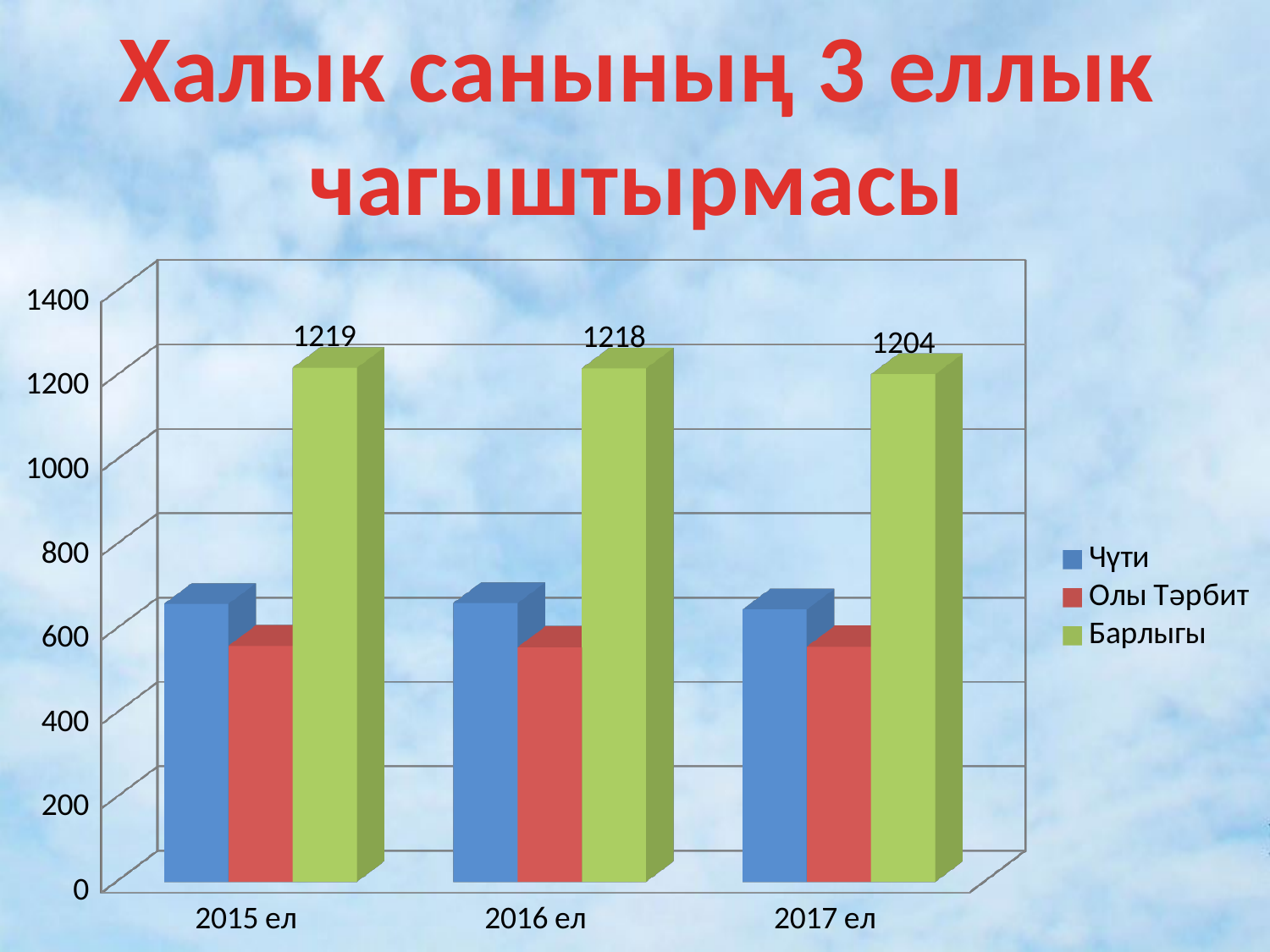
What is the value of Барлыгы for 2015 ел? 1219 What is the difference between the Барлыгы values for 2015 ел and 2017 ел? 15 Which year has the highest Барлыгы value? 2015 ел How many years are shown on the x axis? 3 Which year has the lowest Барлыгы value? 2017 ел In 2015 ел, which is larger: Чүти or Олы Тәрбит? Чүти Is the value for Чүти in 2016 ел greater or less than 800? less How many series does the legend list? 3 Is the value for Олы Тәрбит in 2017 ел greater or less than 400? greater What is the value of Барлыгы for 2017 ел? 1204 Does the Барлыгы value rise or fall from 2015 ел to 2017 ел? fall What is the value of Барлыгы for 2016 ел? 1218